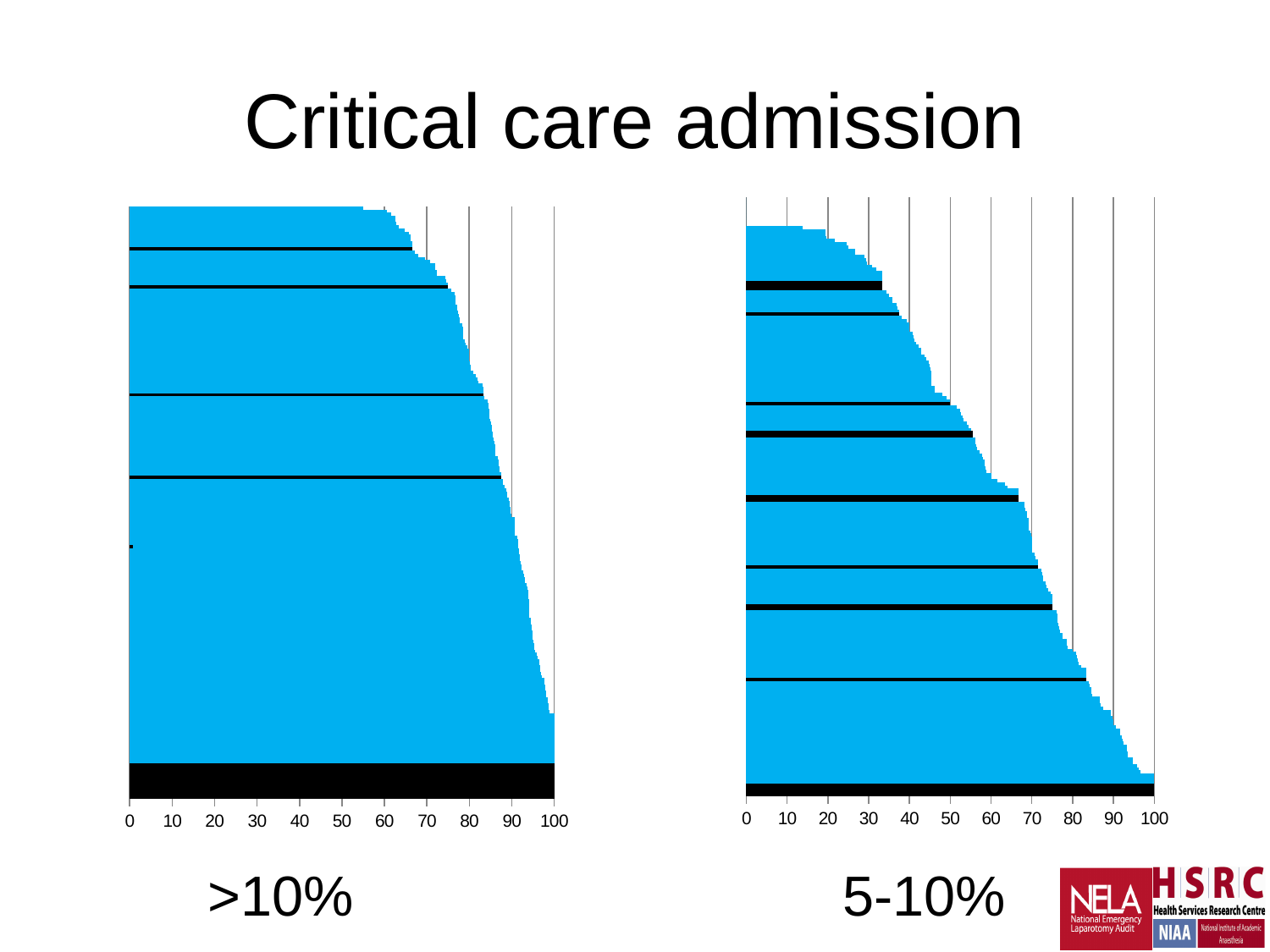
How many charts are on the slide? 2 In the right chart, do the bars get longer or shorter going from top to bottom? longer In the left chart, is the value of the topmost bar greater or less than 50? greater What label appears beneath the left chart? >10% In the right chart, is the value of the bottom (black) bar greater or less than 90? greater What kind of chart is shown on the right side of the slide? bar chart What kind of chart is shown on the left side of the slide? bar chart In the right chart, is the value of the topmost bar greater or less than 30? less In the left chart, do the bars get longer or shorter going from top to bottom? longer What is the title of the slide? Critical care admission